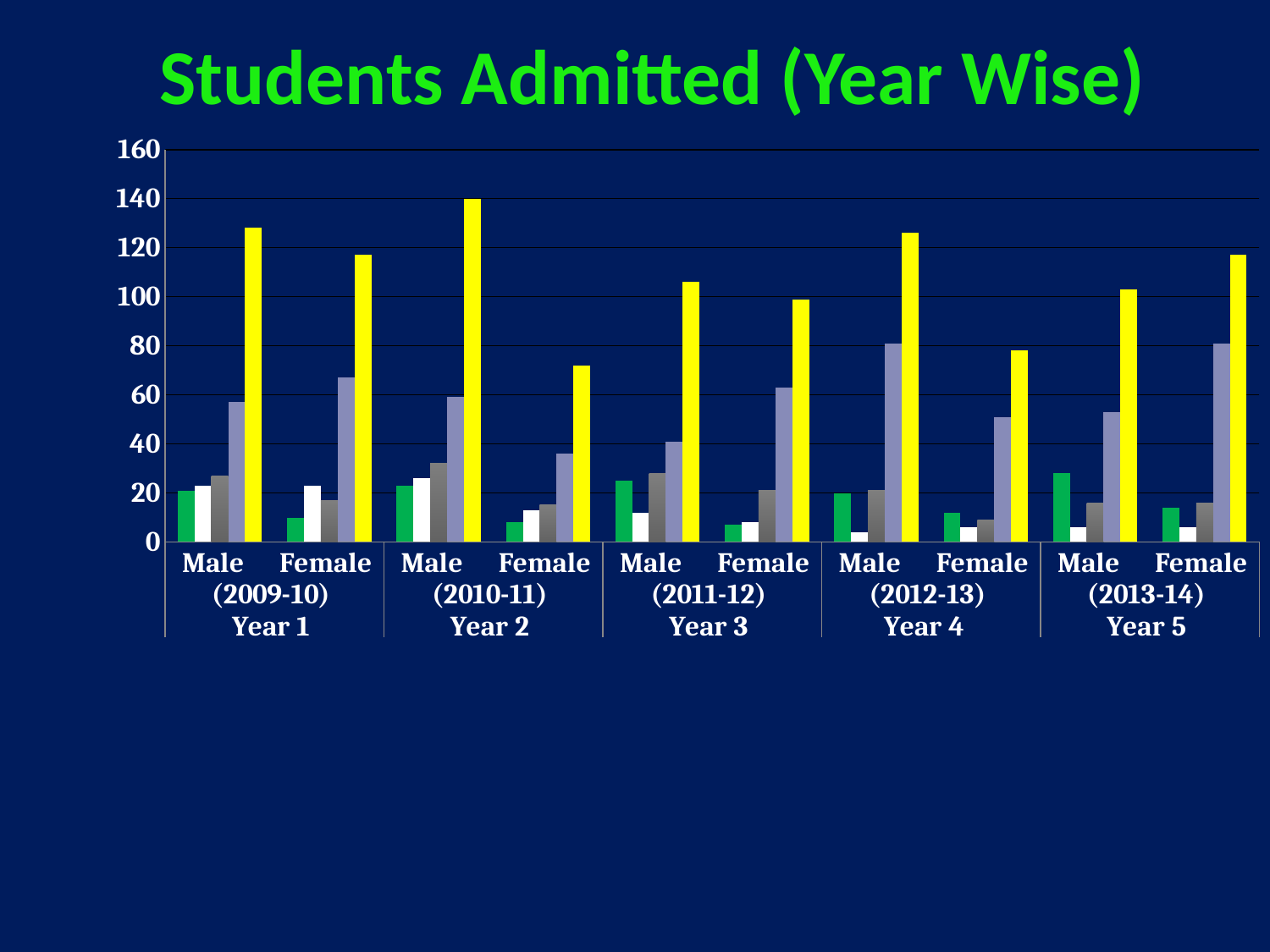
What kind of chart is shown on the slide? bar chart Is the yellow bar for Female (2010-11) Year 2 greater or less than 80? less Which has the larger light purple bar, Male (2012-13) Year 4 or Female (2012-13) Year 4? Male (2012-13) Year 4 What is the title of the chart? Students Admitted (Year Wise) How many bars are plotted for each Male or Female category? 5 Which has the larger yellow bar, Male (2009-10) Year 1 or Female (2009-10) Year 1? Male (2009-10) Year 1 Is the yellow bar for Male (2012-13) Year 4 greater or less than 120? greater Is the yellow bar for Male (2010-11) Year 2 greater or less than 120? greater How many year groups (Year 1 to Year 5) are shown on the x axis? 5 How many Male/Female categories are shown along the x axis? 10 Which category has the tallest yellow bar? Male (2010-11) Year 2